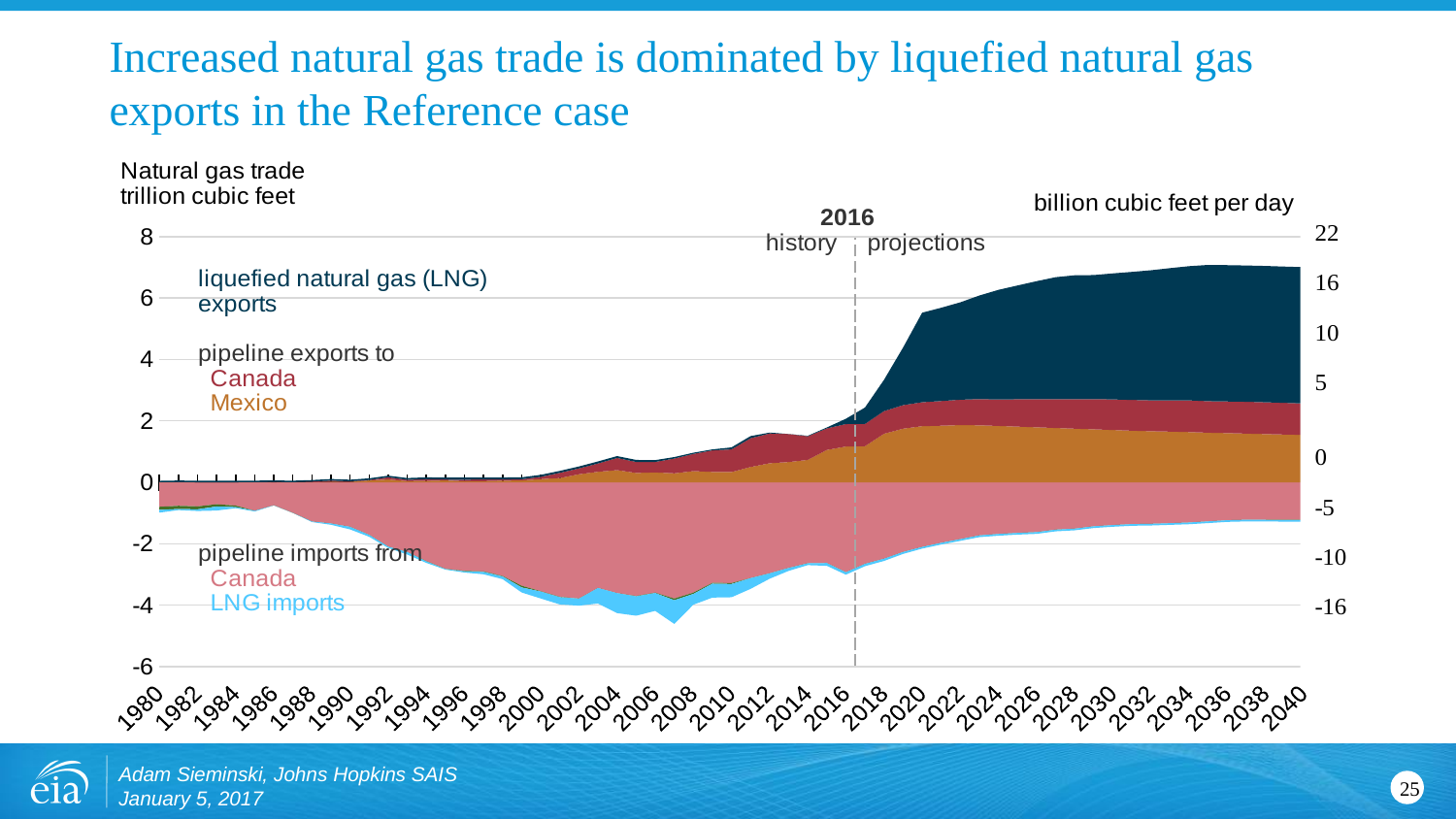
Is the total of the export series in 2000 greater or less than 2 trillion cubic feet? less What is the first year shown on the x axis? 1980 Which import series is larger in 2030: pipeline imports from Canada or LNG imports? pipeline imports from Canada Do liquefied natural gas (LNG) exports rise or fall between 2016 and 2030? rise Is the total of the export series in 2040 greater or less than 6 trillion cubic feet? greater What unit is shown on the left vertical axis of the chart? trillion cubic feet Which export series is the largest in 2040: LNG exports, pipeline exports to Canada, or pipeline exports to Mexico? LNG exports What is the title of the chart? Natural gas trade How many series are labelled on the chart? 5 What kind of chart is shown on the slide? stacked area chart What is the last year shown on the x axis? 2040 In which year does the chart switch from history to projections? 2016